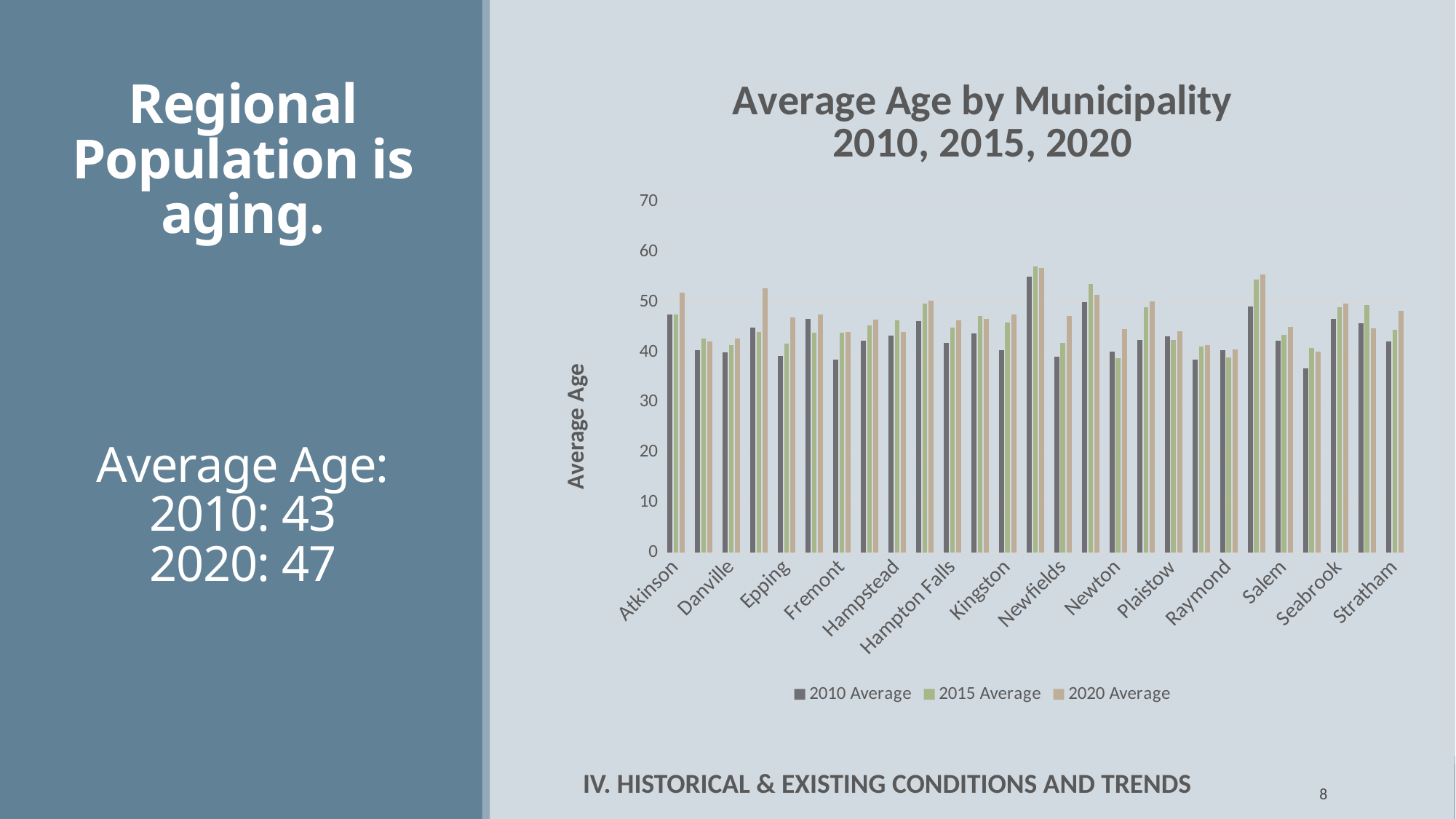
Is the 2010 Average value for Seabrook greater or less than 40? greater What is the label on the vertical axis of the chart? Average Age Which is larger for Epping: the 2010 Average or the 2020 Average? 2020 Average What kind of chart is shown on the slide? Bar chart How many series does the chart's legend list? 3 How many municipalities are shown on the x axis of the chart? 14 Is the 2010 Average value for Danville greater or less than 50? less What is the title of the chart? Average Age by Municipality 2010, 2015, 2020 Is the 2020 Average value for Epping greater or less than 50? less